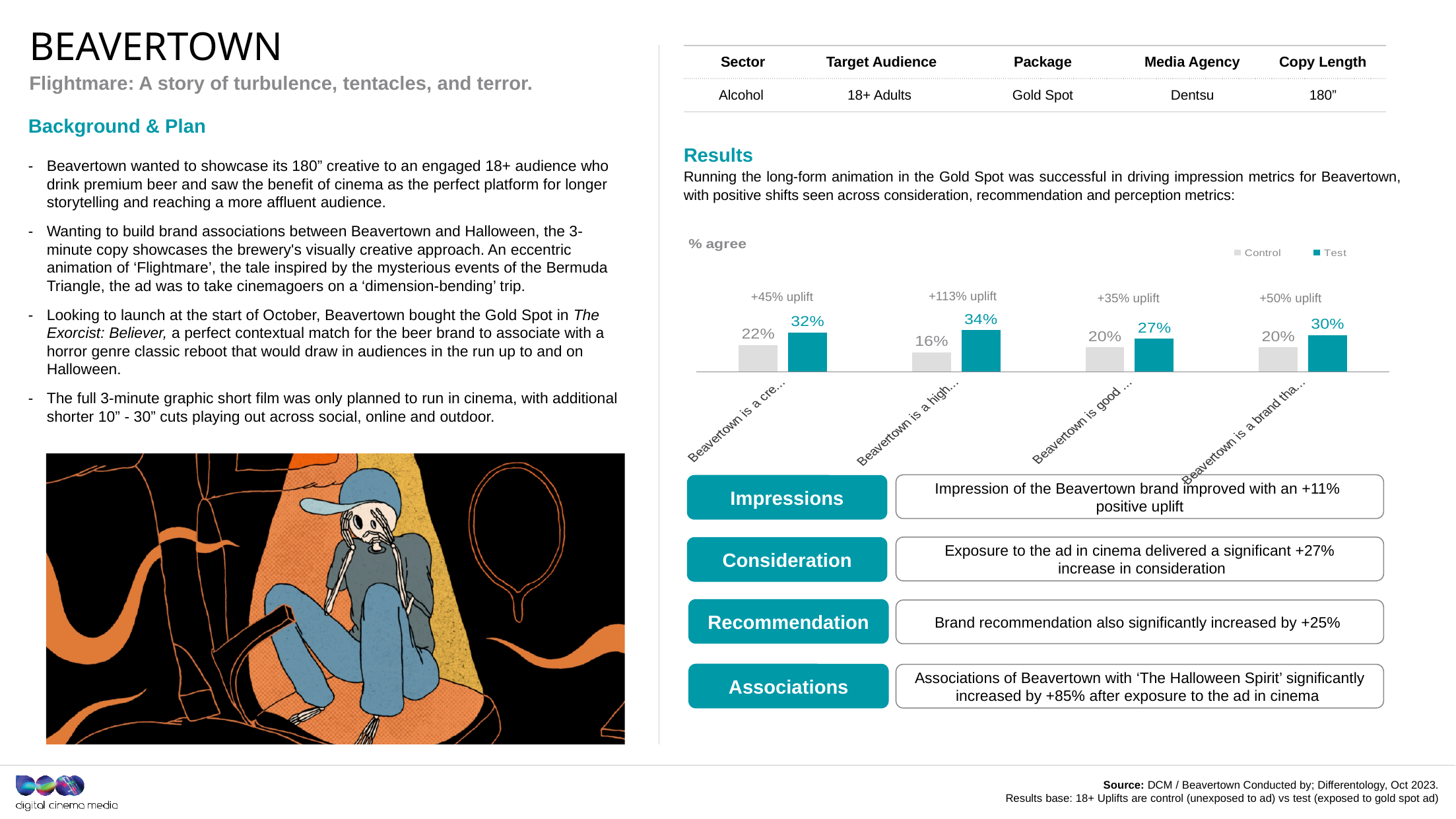
In the "% agree" chart, which category has the highest Test value? Beavertown is a high... In the "% agree" chart, which series is shown in teal? Test In the "% agree" chart, what is the difference between the Test and Control values for the fourth category ("Beavertown is a brand tha...")? 10% In the "% agree" chart, what is the Test value for the first category ("Beavertown is a cre...")? 32% In the "% agree" chart, which is larger for the first category: the Control value or the Test value? Test What kind of chart is shown under the "% agree" heading? bar chart How many categories are plotted on the "% agree" chart? 4 In the "% agree" chart, what is the Control value for the second category ("Beavertown is a high...")? 16% What uplift is labelled above the second category ("Beavertown is a high...") in the "% agree" chart? +113% uplift In the "% agree" chart, which category has the lowest Control value? Beavertown is a high... How many series does the legend of the "% agree" chart list? 2 In the "% agree" chart, what is the Test value for the third category ("Beavertown is good ...")? 27%